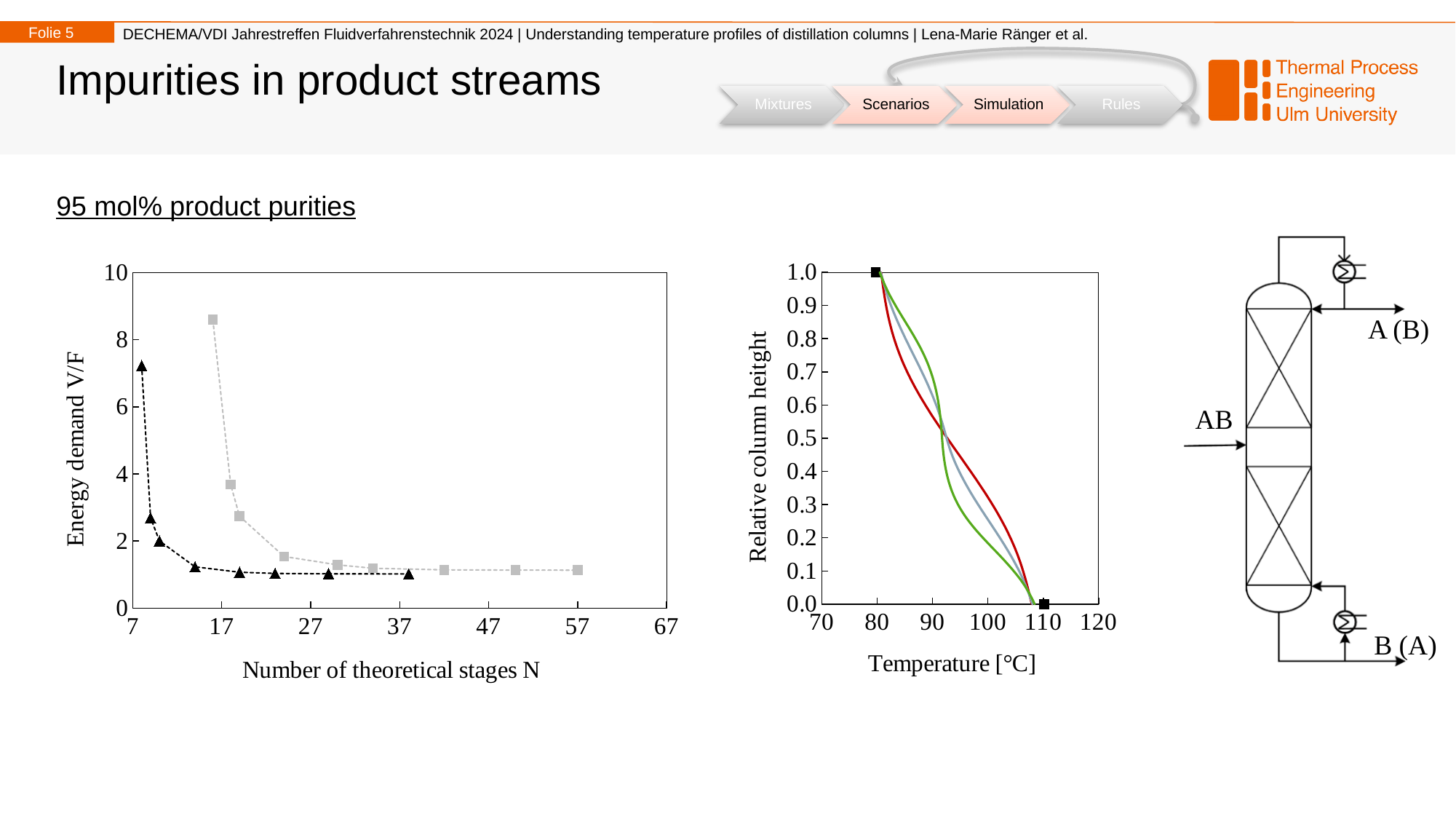
In the right chart, does the relative column height rise or fall as temperature increases? fall In the left chart, is the energy demand V/F of the black triangle series at about 37 stages greater or less than 2? less What kind of chart is the left chart, Energy demand V/F versus Number of theoretical stages N? line chart with markers In the left chart, what is the label of the y axis? Energy demand V/F In the left chart, is the highest value of the black triangle series greater or less than 6? greater In the left chart, does the energy demand V/F rise or fall as the number of theoretical stages N increases? fall In the left chart, which series reaches the higher maximum energy demand V/F, the black triangles or the grey squares? grey squares In the left chart, is the highest value of the grey square series greater or less than 8? greater In the right chart, what is the label of the x axis? Temperature [°C] In the left chart, what is the label of the x axis? Number of theoretical stages N In the right chart, how many coloured curves are plotted? 3